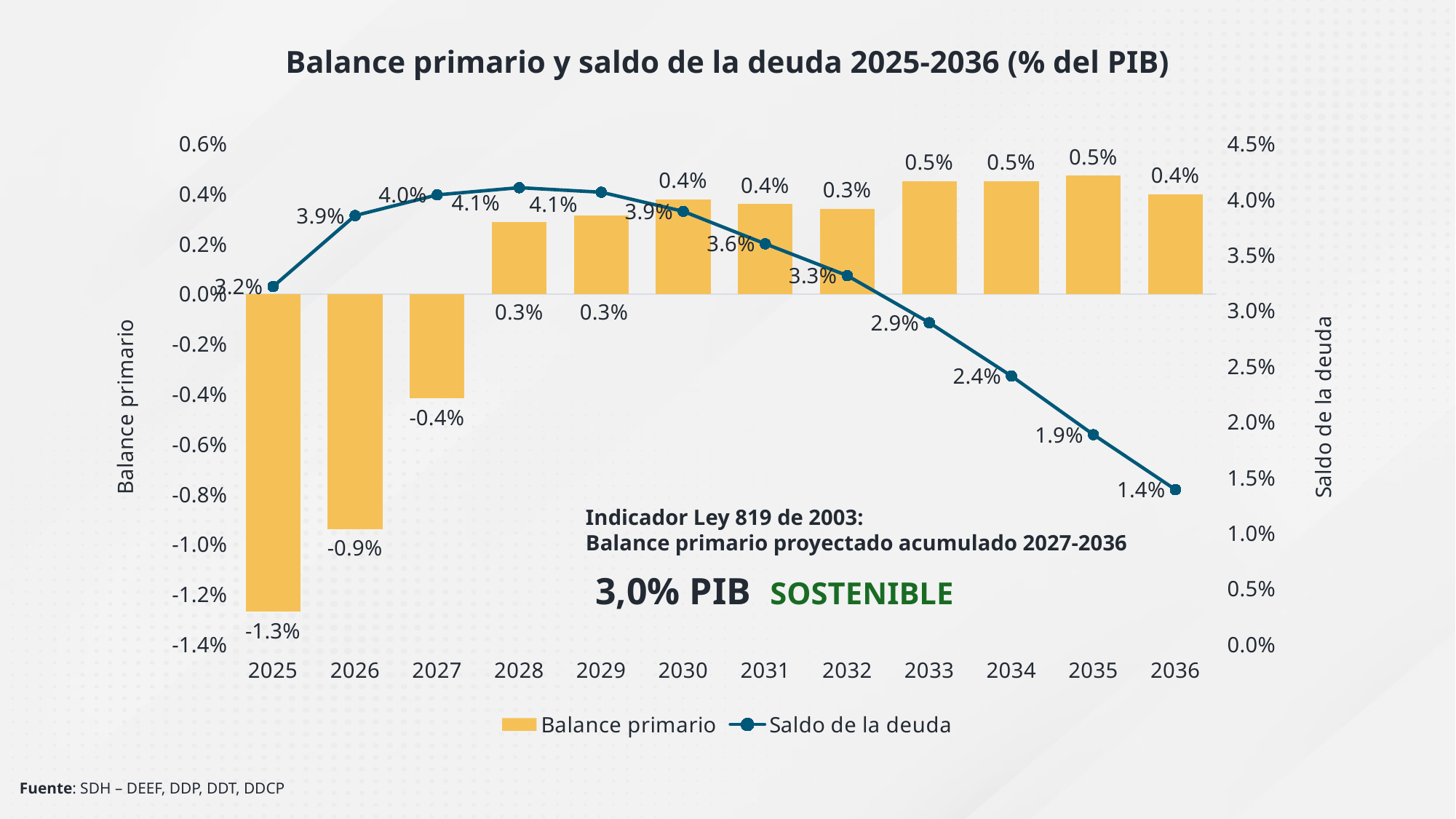
How many years are shown on the x axis? 12 In which year is Balance primario lowest? 2025 How many series does the legend list? 2 What kind of chart is this? Combined bar and line chart In which year is Saldo de la deuda lowest? 2036 What is the value of Saldo de la deuda for 2036? 1.4% Does Saldo de la deuda rise or fall from 2029 to 2036? Fall What is the value of Saldo de la deuda for 2031? 3.6% What is the value of Balance primario for 2025? -1.3% What is the value of Balance primario for 2033? 0.5% Which year has a higher Saldo de la deuda, 2026 or 2032? 2026 What is the difference between Saldo de la deuda in 2025 and in 2036? 1.8 percentage points